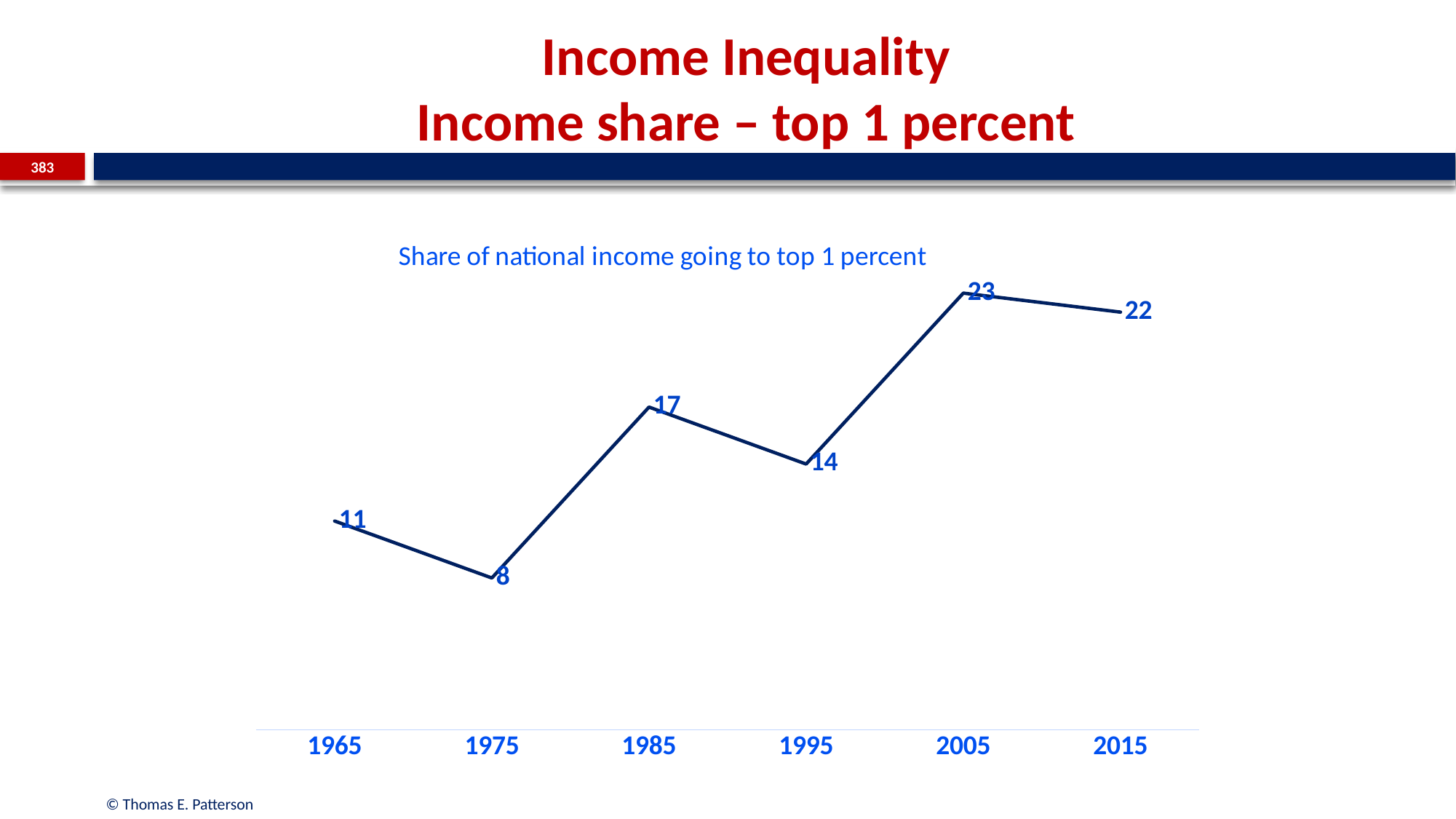
In which year is the share of national income going to the top 1 percent highest? 2005 What is the share of national income going to the top 1 percent in 1975? 8 What is the difference between the share in 1985 and the share in 1995? 3 What kind of chart is shown on the slide? line chart In which year is the share of national income going to the top 1 percent lowest? 1975 What is the difference between the share in 2005 and the share in 1965? 12 What is the share of national income going to the top 1 percent in 1965? 11 What is the title of the chart? Share of national income going to top 1 percent What is the share of national income going to the top 1 percent in 2005? 23 Which year has a larger share, 1985 or 1995? 1985 How many years are plotted on the chart? 6 What is the share of national income going to the top 1 percent in 2015? 22